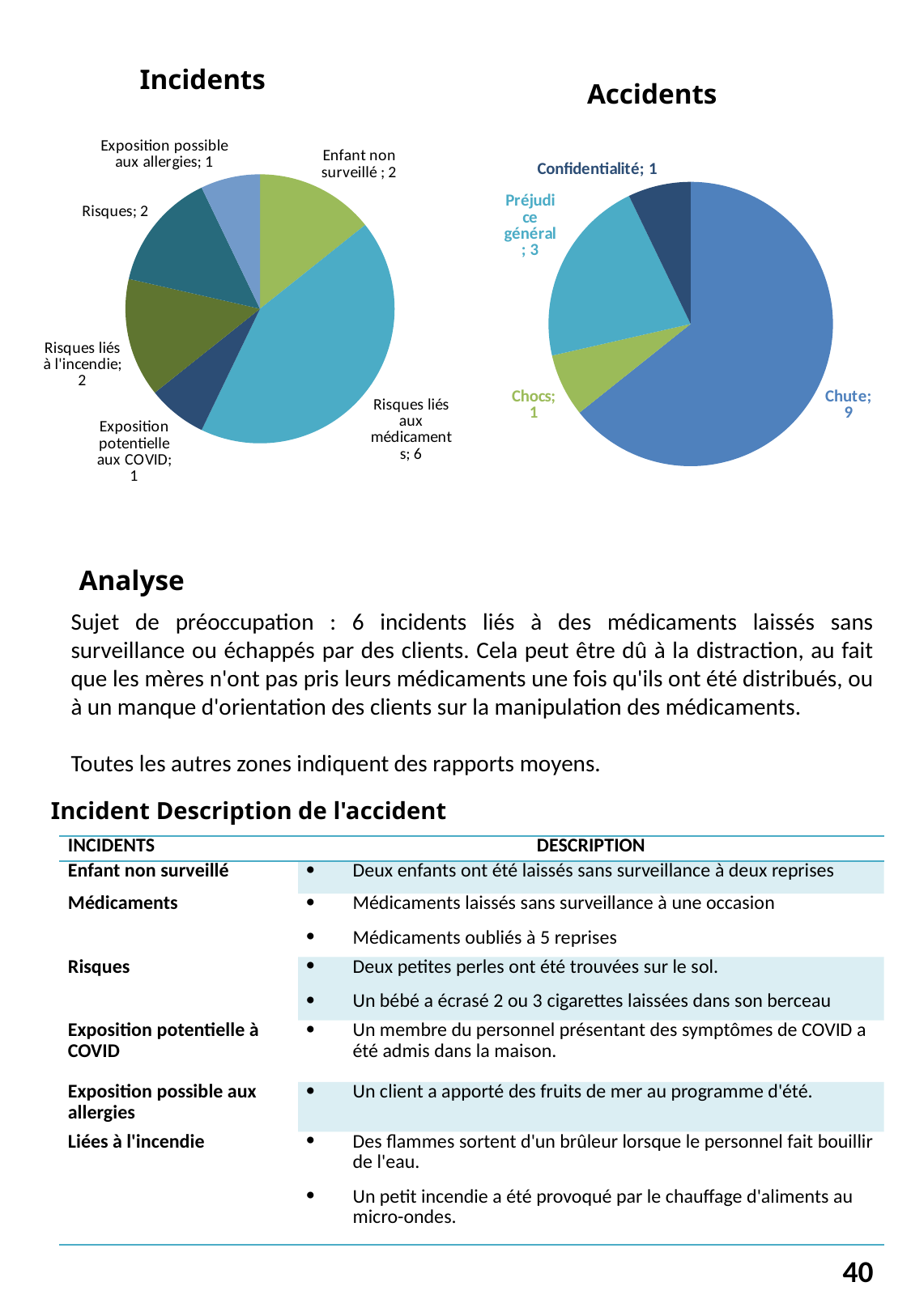
How many categories does the Incidents pie chart have? 6 In the Incidents chart, what is the value for Risques liés aux médicaments? 6 In the Incidents chart, what is the difference between Risques liés aux médicaments and Enfant non surveillé? 4 In the Accidents chart, which category has the largest slice? Chute In the Incidents chart, which category has the largest slice? Risques liés aux médicaments In the Incidents chart, which is larger: Risques or Exposition possible aux allergies? Risques In the Accidents chart, what is the total of all slices? 14 How many categories does the Accidents pie chart have? 4 In the Accidents chart, what is the difference between Chute and Préjudice général? 6 In the Accidents chart, what is the value for Préjudice général? 3 In the Accidents chart, what is the value for Chute? 9 What type of chart is the Accidents chart? Pie chart